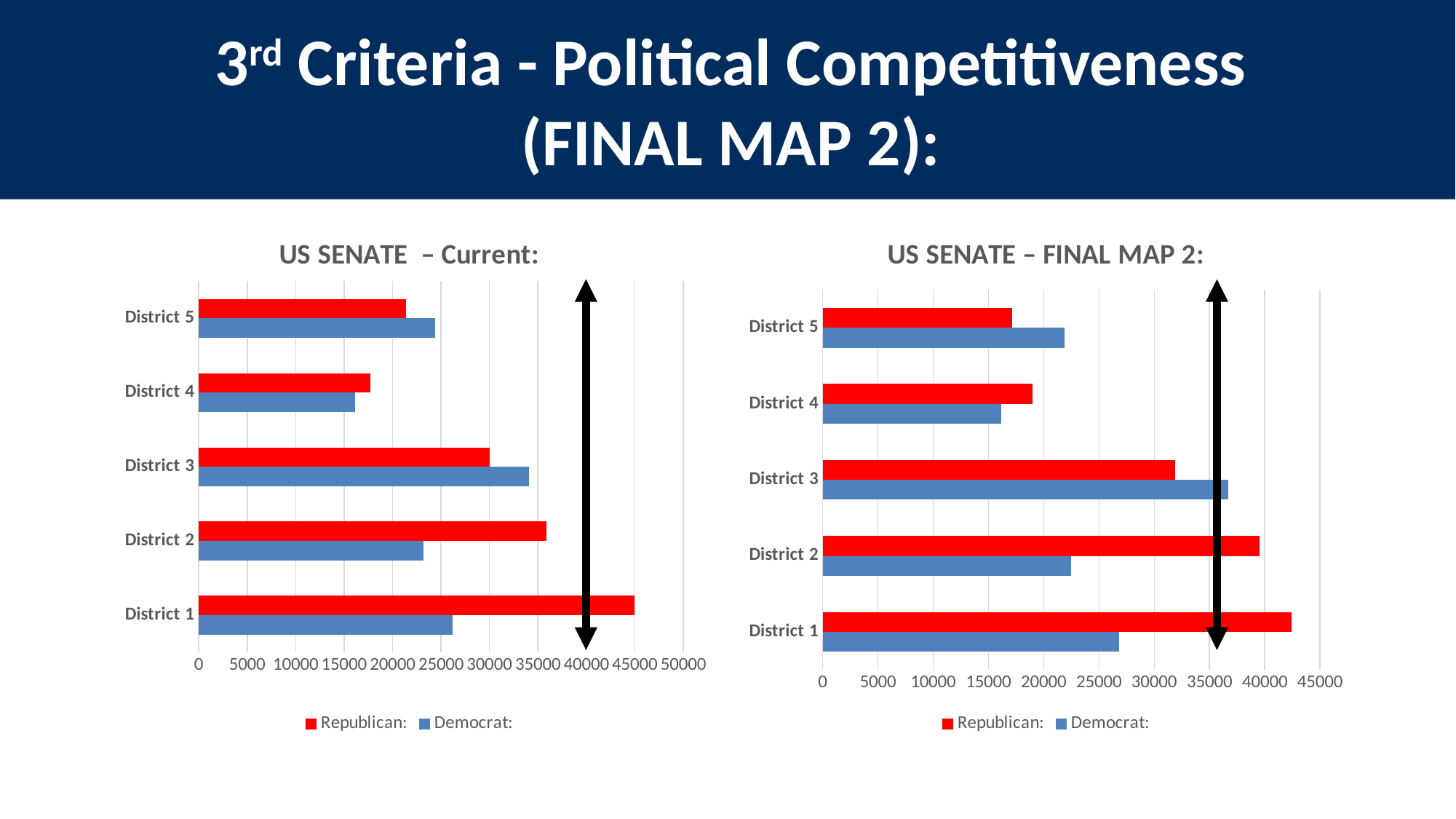
In the US SENATE – FINAL MAP 2 chart, how many series does the legend list? 2 In the US SENATE – Current chart, which district has the lowest Democrat value? District 4 In the US SENATE – FINAL MAP 2 chart, which district has the highest Democrat value? District 3 In the US SENATE – Current chart, is the Democrat value for District 3 greater or less than 30000? greater In the US SENATE – Current chart, which district has the highest Republican value? District 1 In the US SENATE – Current chart, what kind of chart is shown? bar chart In the US SENATE – FINAL MAP 2 chart, which district has the lowest Republican value? District 5 In the US SENATE – FINAL MAP 2 chart, is the Republican value for District 2 greater or less than 35000? greater In the US SENATE – Current chart, what colour are the Republican bars? red In the US SENATE – Current chart, how many districts are plotted? 5 In the US SENATE – Current chart, is the Republican value for District 1 greater or less than 40000? greater In the US SENATE – FINAL MAP 2 chart, which is larger for District 5, the Republican value or the Democrat value? Democrat